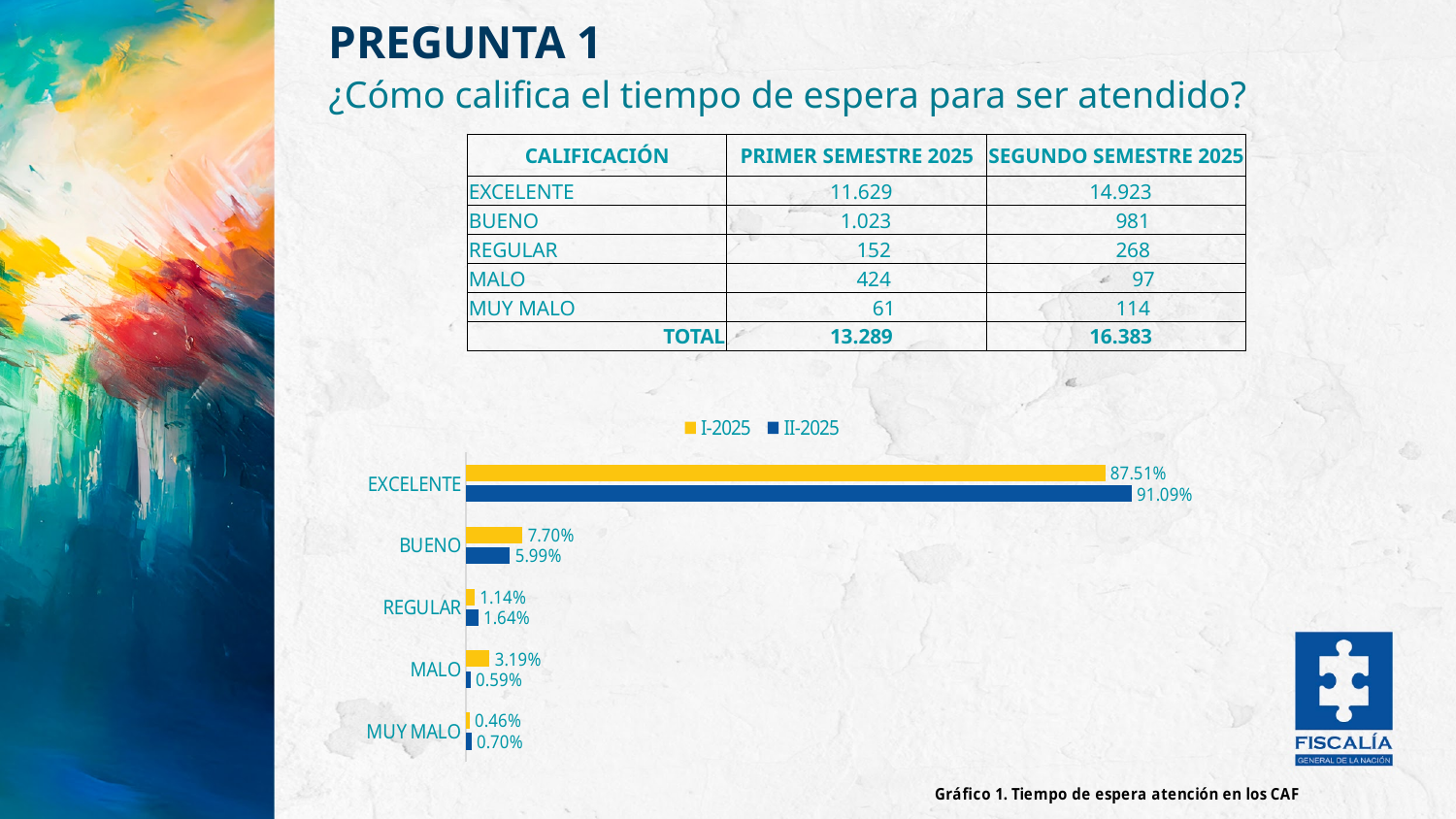
What is the value for MUY MALO in the II-2025 series? 0.70% What is the value for MALO in the I-2025 series? 3.19% What is the difference between the I-2025 and II-2025 values for MALO? 2.60% For BUENO, which series has the larger value, I-2025 or II-2025? I-2025 What is the value for EXCELENTE in the I-2025 series? 87.51% What is the difference between the II-2025 and I-2025 values for EXCELENTE? 3.58% Which category has the highest value in the II-2025 series? EXCELENTE Which category has the lowest value in the I-2025 series? MUY MALO What kind of chart is shown on the slide? Bar chart How many series does the legend list? 2 What is the value for EXCELENTE in the II-2025 series? 91.09% How many categories are shown in the chart? 5